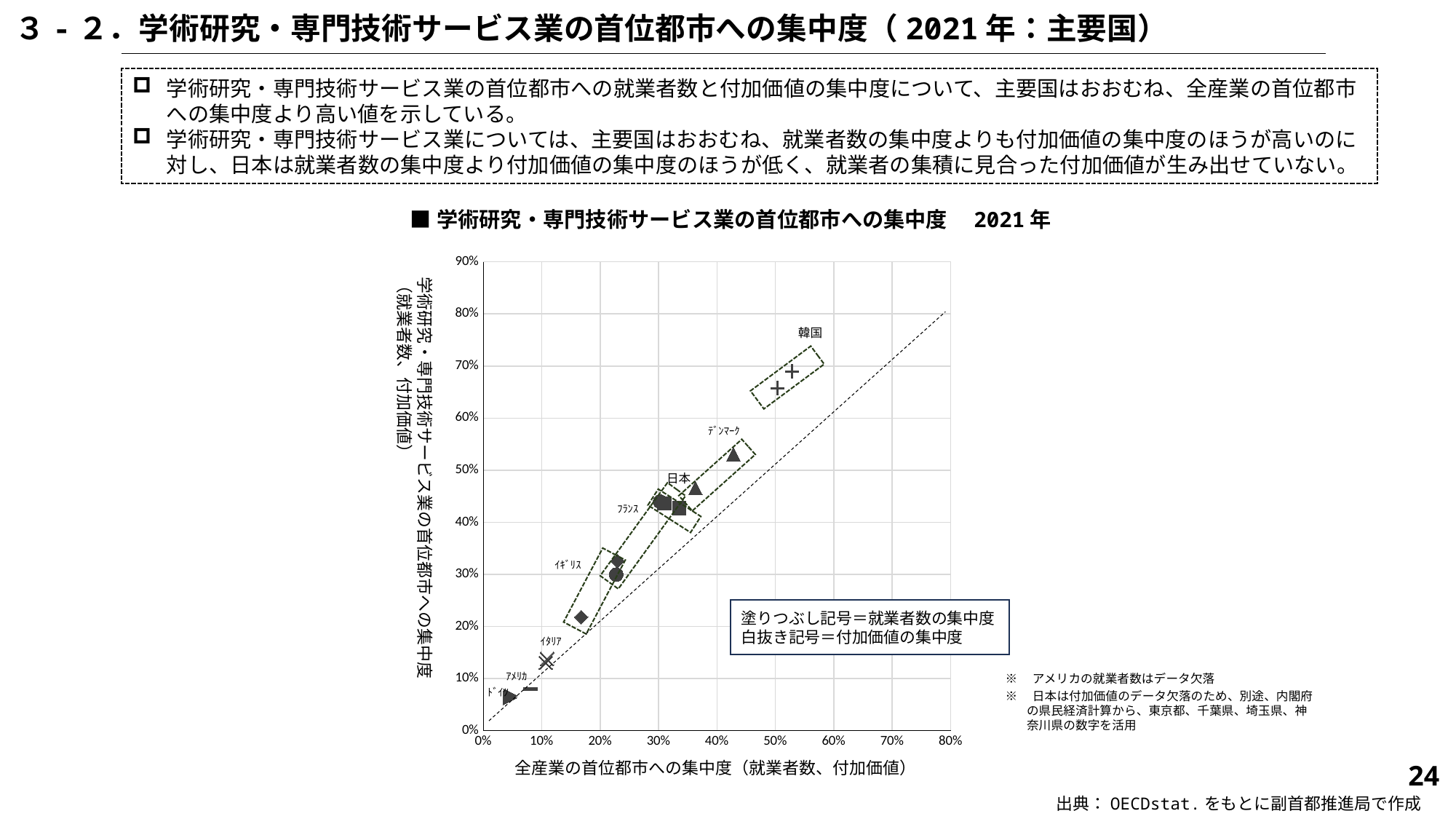
Do the plotted points generally rise or fall as the horizontal-axis value increases? rise Are the vertical-axis values for 韓国 greater or less than 60%? greater According to the legend box on the chart, what do the filled symbols (塗りつぶし記号) represent? 就業者数の集中度 Are the horizontal-axis values for 韓国 greater or less than 40%? greater Which country is plotted higher on the vertical axis, 韓国 or デンマーク? 韓国 Which country has the lowest values on the vertical axis? ドイツ How many countries are labelled on the scatter chart? 8 Are the vertical-axis values for イギリス greater or less than 40%? less Which country is plotted higher on the vertical axis, 日本 or イギリス? 日本 Which country has the highest values on the vertical axis (学術研究・専門技術サービス業の首位都市への集中度)? 韓国 What kind of chart is shown on the slide? scatter chart